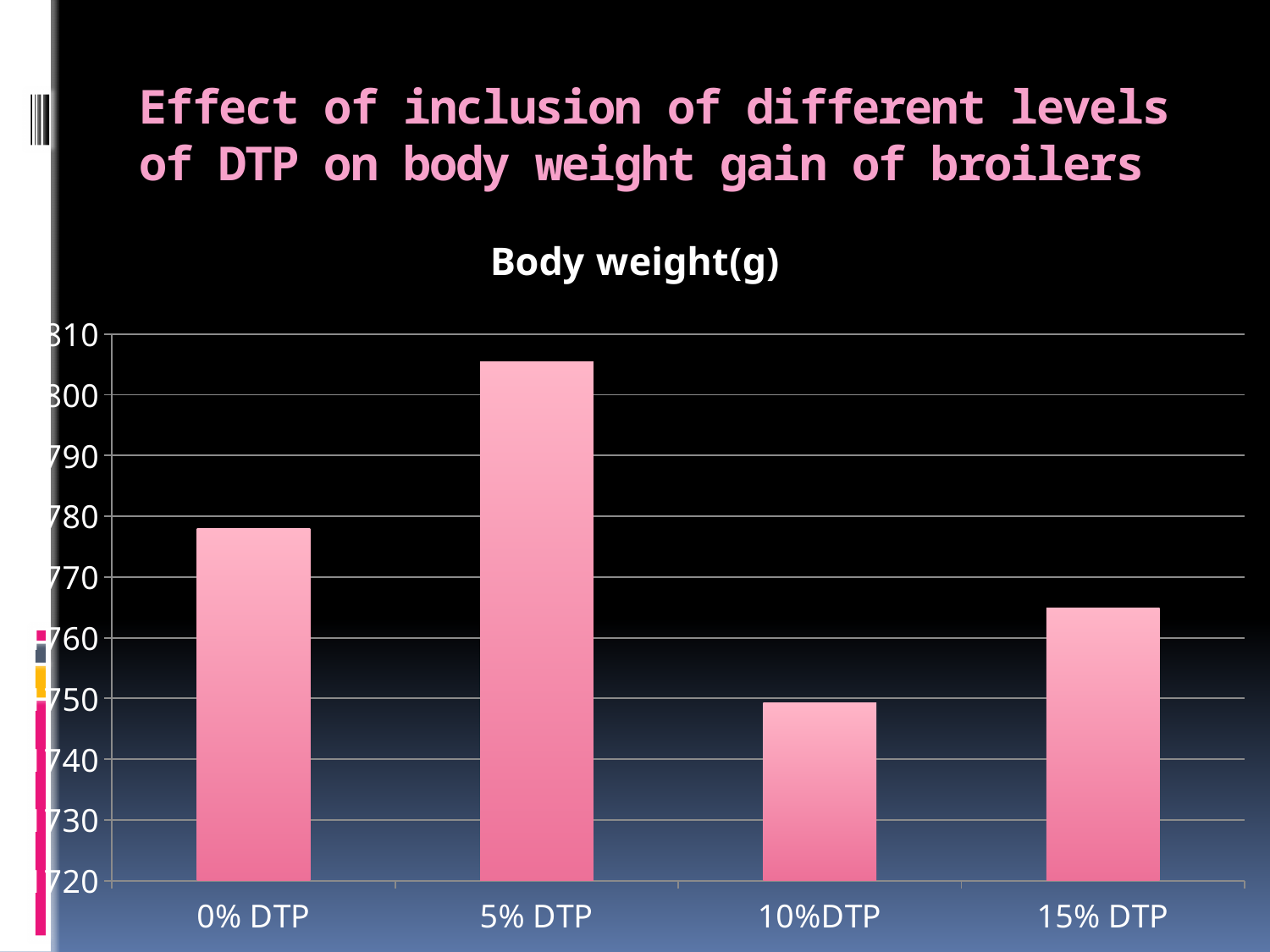
What kind of chart is shown on the slide? bar chart Is the body weight for 5% DTP greater or less than 800? greater Which DTP level has the lowest body weight? 10%DTP Which has a larger body weight, 0% DTP or 15% DTP? 0% DTP Is the body weight for 0% DTP greater or less than 770? greater Which DTP level has the highest body weight? 5% DTP Which has a larger body weight, 10%DTP or 15% DTP? 15% DTP What is the title of the chart? Body weight(g) How many categories are shown on the x axis of the chart? 4